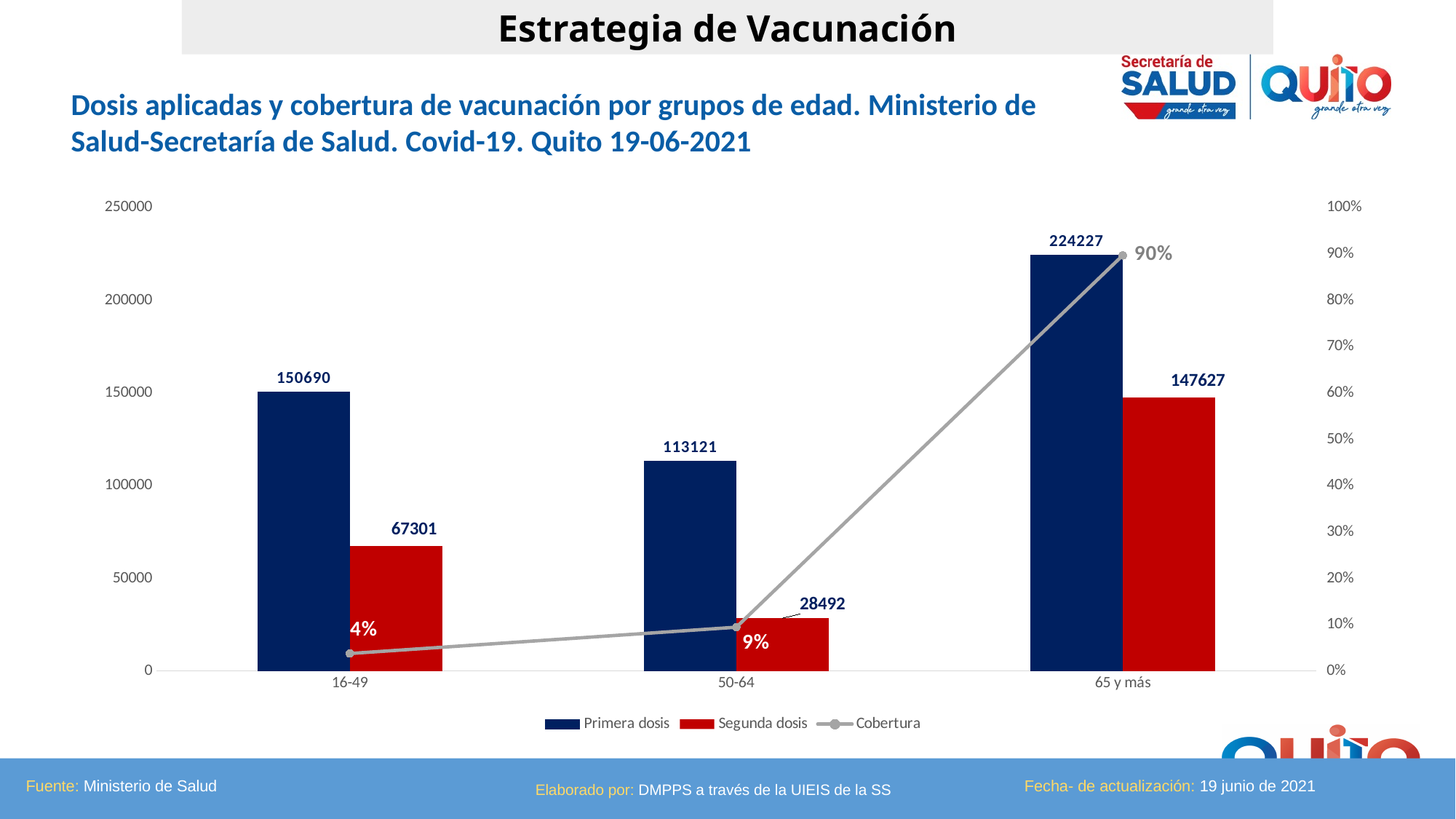
How many age groups are shown on the x axis? 3 Which age group has the highest Primera dosis value? 65 y más Which is larger: Segunda dosis for 16-49 or Segunda dosis for 50-64? Segunda dosis for 16-49 Is the Primera dosis value for 50-64 greater or less than 100000? greater What is the value of Segunda dosis for the 50-64 age group? 28492 Which age group has the lowest Segunda dosis value? 50-64 What is the difference between Primera dosis and Segunda dosis for the 65 y más age group? 76600 What is the value of Primera dosis for the 16-49 age group? 150690 What is the Cobertura value for the 65 y más age group? 90% Does the Cobertura line rise or fall from 16-49 to 65 y más? rise How many series does the legend list? 3 Which series is shown in red? Segunda dosis